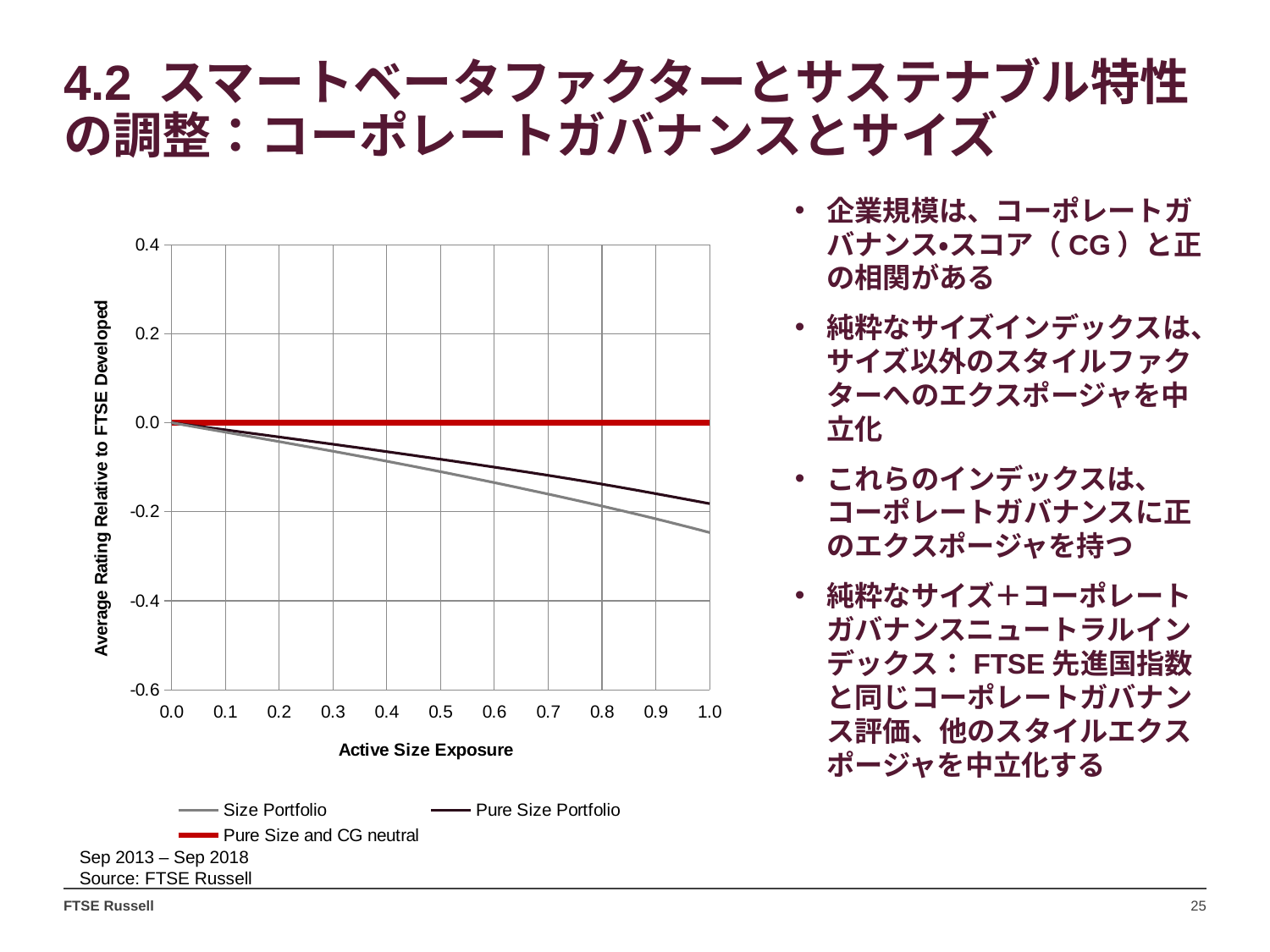
How many series does the chart legend list? 3 At an Active Size Exposure of 1.0, is the value for Pure Size Portfolio greater or less than -0.4? greater What is the title of the x axis of the chart? Active Size Exposure Does the Size Portfolio line rise or fall as Active Size Exposure increases from 0.0 to 1.0? fall At an Active Size Exposure of 0.5, is the value for Pure Size Portfolio greater or less than -0.2? greater What is the title of the y axis of the chart? Average Rating Relative to FTSE Developed What kind of chart is shown on the slide? line chart Does the Pure Size and CG neutral line rise, fall, or stay flat as Active Size Exposure increases? stay flat Which series has the lowest value at an Active Size Exposure of 1.0? Size Portfolio At an Active Size Exposure of 1.0, is the value for Size Portfolio greater or less than -0.2? less What is the value of the Pure Size and CG neutral series at an Active Size Exposure of 1.0? 0.0 At an Active Size Exposure of 1.0, which is higher: Size Portfolio or Pure Size Portfolio? Pure Size Portfolio